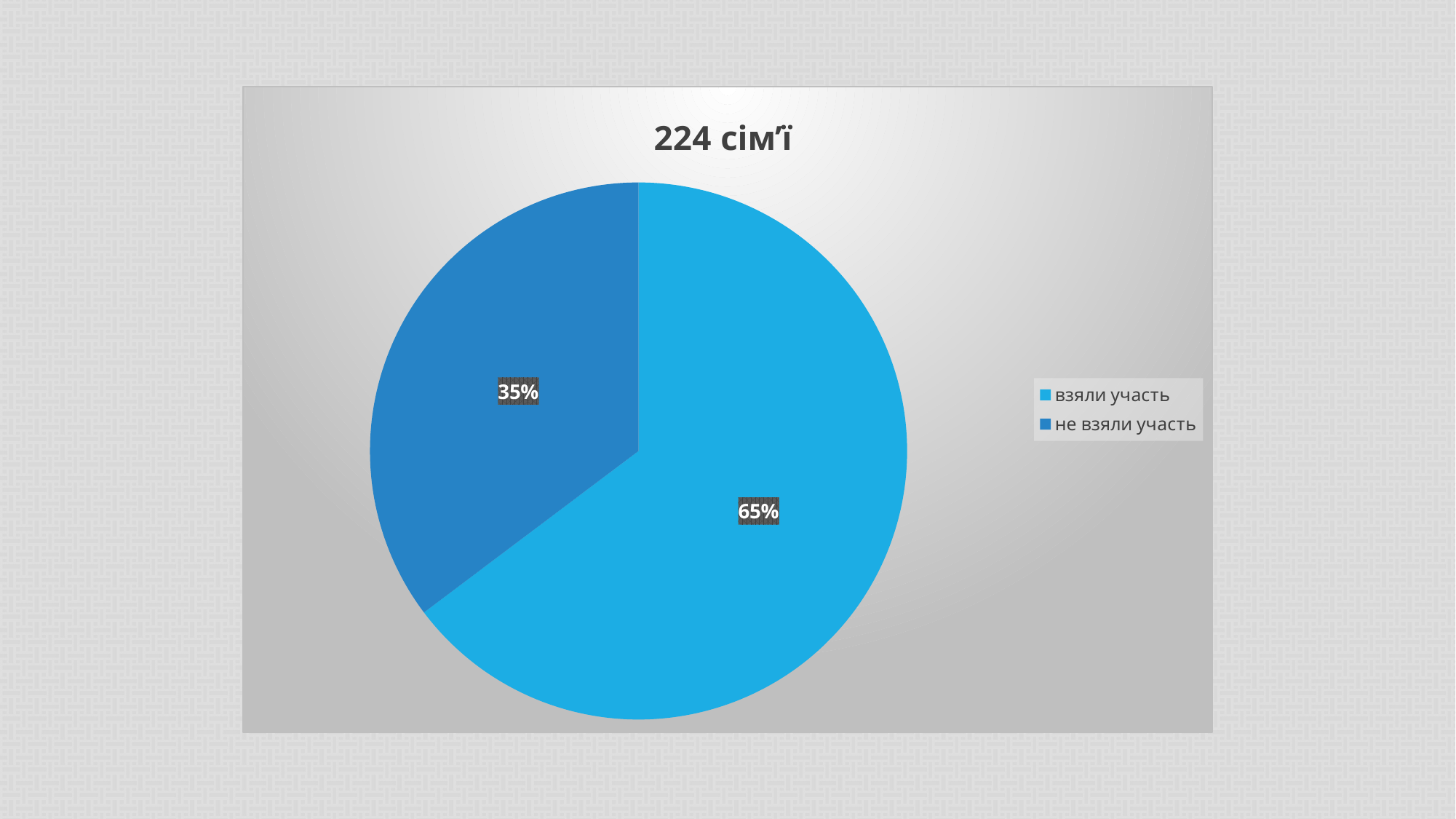
How many entries does the legend list? 2 What share of the pie is labelled "не взяли участь"? 35% Which slice is the largest? взяли участь Which legend entry is shown in the darker blue colour? не взяли участь What is the title of the chart? 224 сім'ї Which is larger: the "взяли участь" slice or the "не взяли участь" slice? взяли участь How many slices does the pie chart have? 2 What is the difference in percentage points between the "взяли участь" and "не взяли участь" slices? 30 percentage points Which slice is the smallest? не взяли участь Is the value for "взяли участь" greater or less than 50%? greater What share of the pie is labelled "взяли участь"? 65% What kind of chart is shown on the slide? pie chart